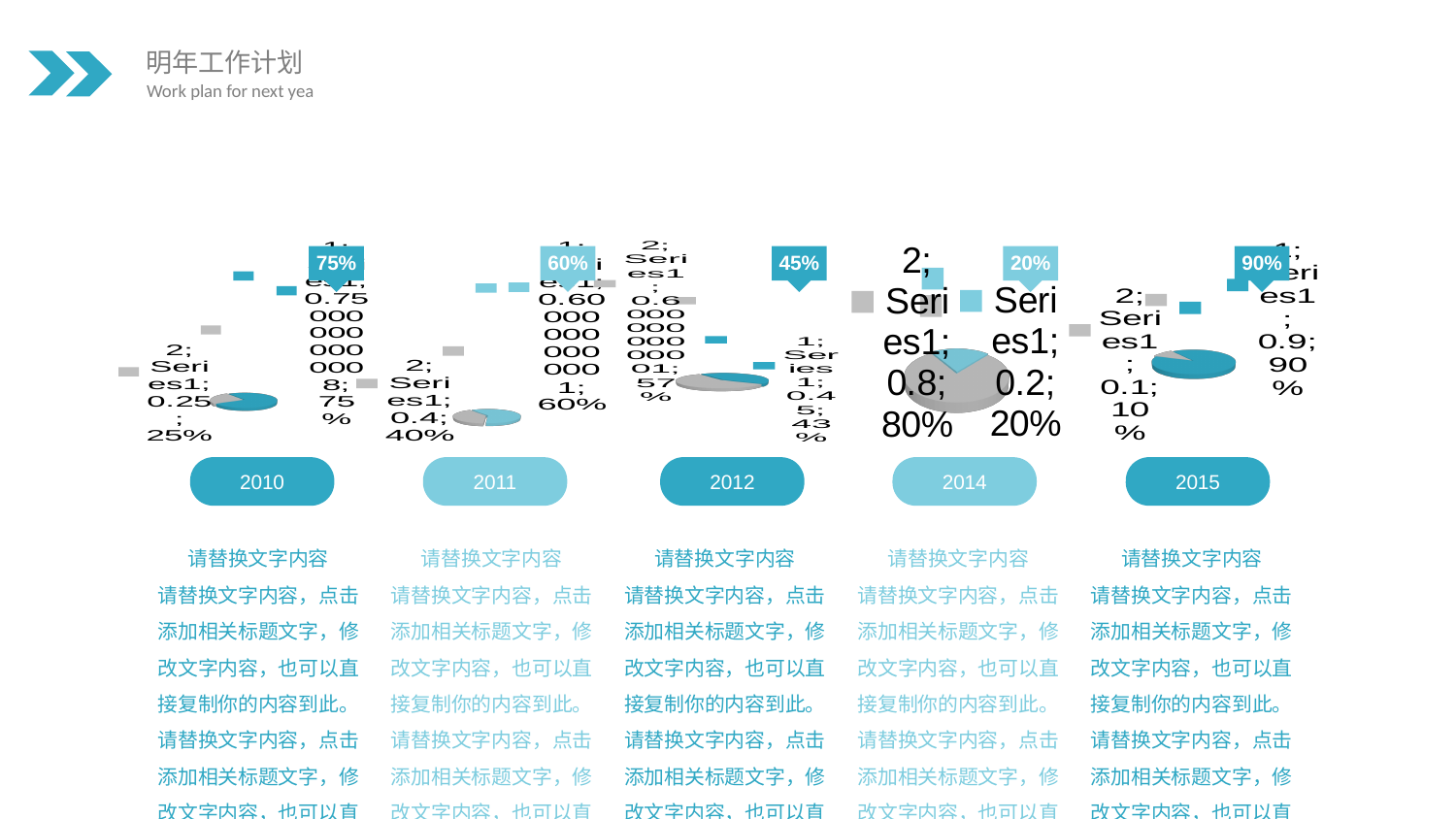
What kind of charts are shown above the year labels on the slide? Pie charts What percentage is shown in the callout above the 2015 pie chart? 90% In the 2014 pie chart, what share does the larger (grey) slice have according to its data label? 80% What percentage is shown in the callout above the 2011 pie chart? 60% What percentage is shown in the callout above the 2010 pie chart? 75% What percentage is shown in the callout above the 2014 pie chart? 20% Which year's chart has the highest percentage in its callout? 2015 In the 2015 pie chart, what share does the smaller slice have according to its data label? 10% In the 2010 pie chart, what share does the smaller slice have according to its data label? 25% Which year's chart has the lowest percentage in its callout? 2014 How many pie charts are on the slide? 5 What percentage is shown in the callout above the 2012 pie chart? 45%